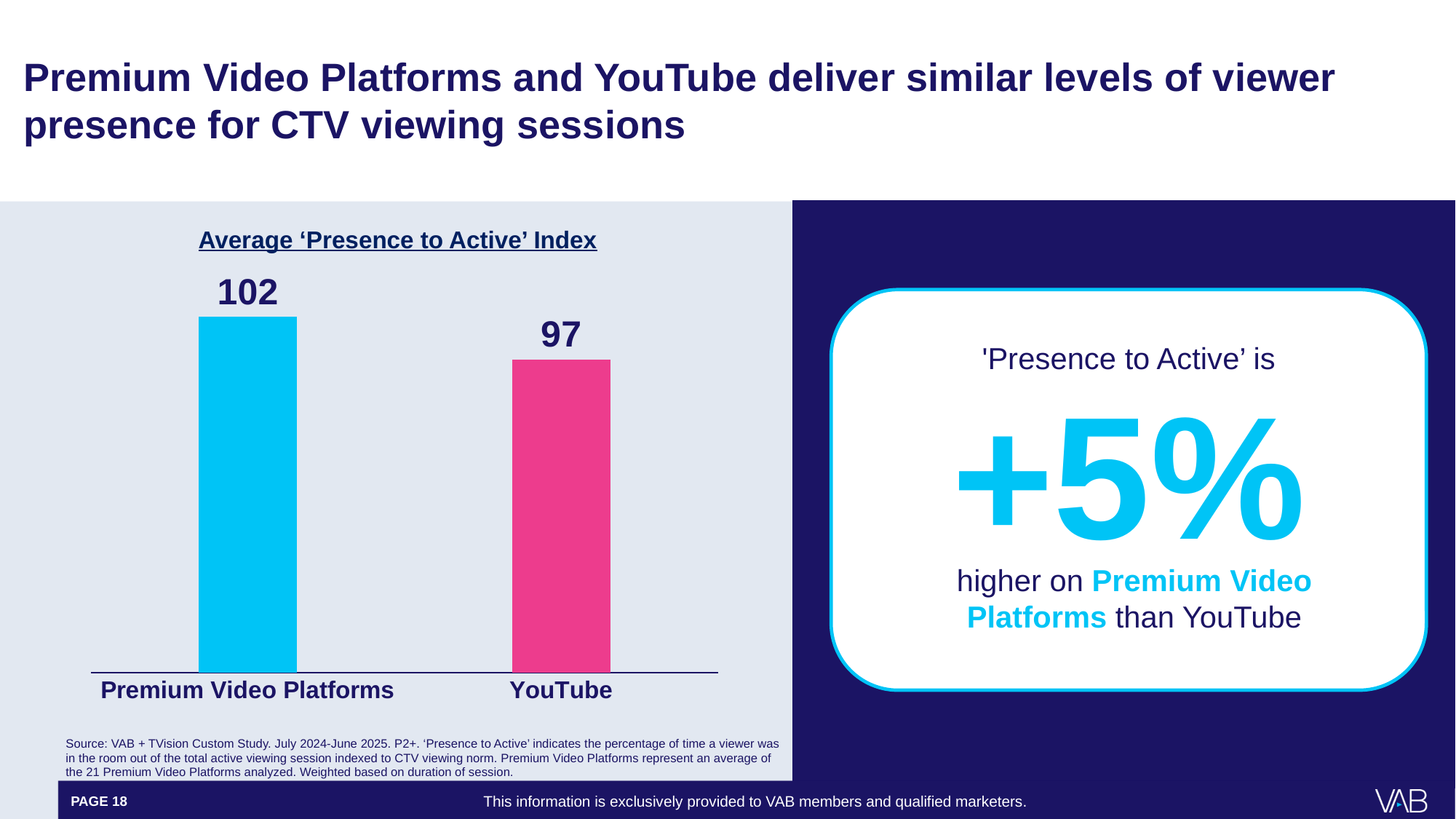
How many categories are shown in the chart? 2 What colour is the bar for YouTube? pink Which category has the higher Average 'Presence to Active' Index? Premium Video Platforms What is the difference between the index values for Premium Video Platforms and YouTube? 5 What is the Average 'Presence to Active' Index for Premium Video Platforms? 102 Which category has the lower Average 'Presence to Active' Index? YouTube Is the index value for Premium Video Platforms larger or smaller than the value for YouTube? larger What is the title of the chart? Average 'Presence to Active' Index Do the values rise or fall from Premium Video Platforms to YouTube along the x axis? fall What kind of chart is shown on the slide? bar chart What is the Average 'Presence to Active' Index for YouTube? 97